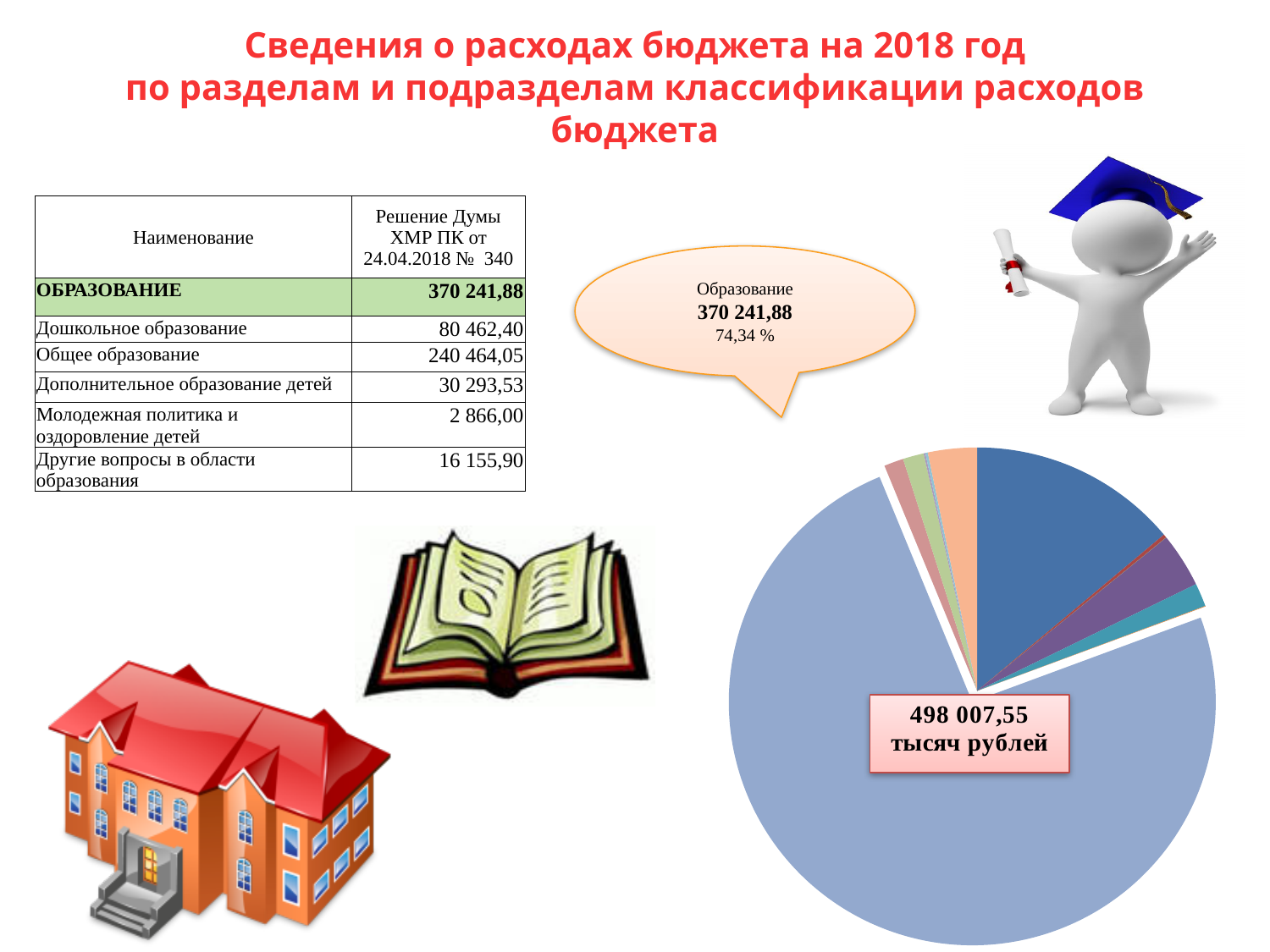
What total amount is printed on the pie chart? 498 007,55 тысяч рублей What colour is the largest slice of the pie chart? light blue What kind of chart is shown on the slide? pie chart Does the pie chart have a legend? No Which category does the largest slice of the pie chart represent, according to the callout? Образование According to the callout on the pie chart, what is the value for Образование? 370 241,88 According to the callout pointing at the pie chart, what share of the budget does Образование represent? 74,34 % Is the share of the largest slice of the pie chart greater or less than 50%? greater